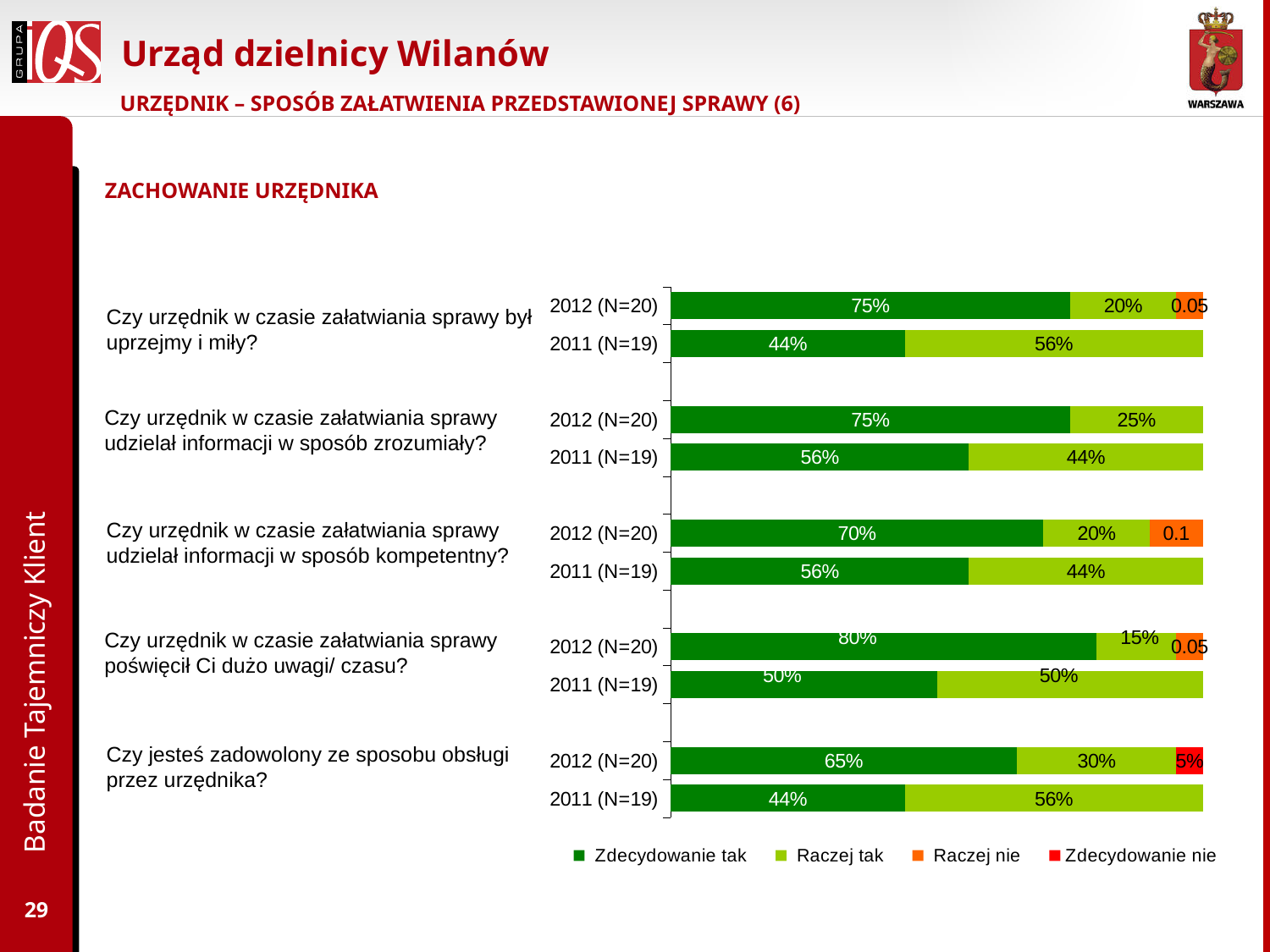
What is the 'Raczej nie' value for 2012 (N=20) for the question 'Czy urzędnik w czasie załatwiania sprawy udzielał informacji w sposób kompetentny?'? 0.1 What is the 'Raczej tak' value for 2011 (N=19) for the question 'Czy urzędnik w czasie załatwiania sprawy był uprzejmy i miły?'? 56% What is the difference between the 'Zdecydowanie tak' values for 2012 (N=20) and 2011 (N=19) for the question 'Czy urzędnik w czasie załatwiania sprawy był uprzejmy i miły?'? 31% What is the 'Zdecydowanie nie' value for 2012 (N=20) for the question 'Czy jesteś zadowolony ze sposobu obsługi przez urzędnika?'? 5% What is the 'Zdecydowanie tak' value for 2012 (N=20) for the question 'Czy urzędnik w czasie załatwiania sprawy poświęcił Ci dużo uwagi/ czasu?'? 80% Which 2012 (N=20) bar has the highest 'Zdecydowanie tak' value? Czy urzędnik w czasie załatwiania sprawy poświęcił Ci dużo uwagi/ czasu? What is the 'Raczej tak' value for 2012 (N=20) for the question 'Czy urzędnik w czasie załatwiania sprawy udzielał informacji w sposób zrozumiały?'? 25% What is the 'Zdecydowanie tak' value for 2012 (N=20) for the question 'Czy urzędnik w czasie załatwiania sprawy był uprzejmy i miły?'? 75% For the question 'Czy jesteś zadowolony ze sposobu obsługi przez urzędnika?', which year has the larger 'Zdecydowanie tak' value, 2012 (N=20) or 2011 (N=19)? 2012 (N=20) How many bars are plotted in the chart? 10 How many series does the legend list? 4 What kind of chart is shown on the slide? stacked bar chart